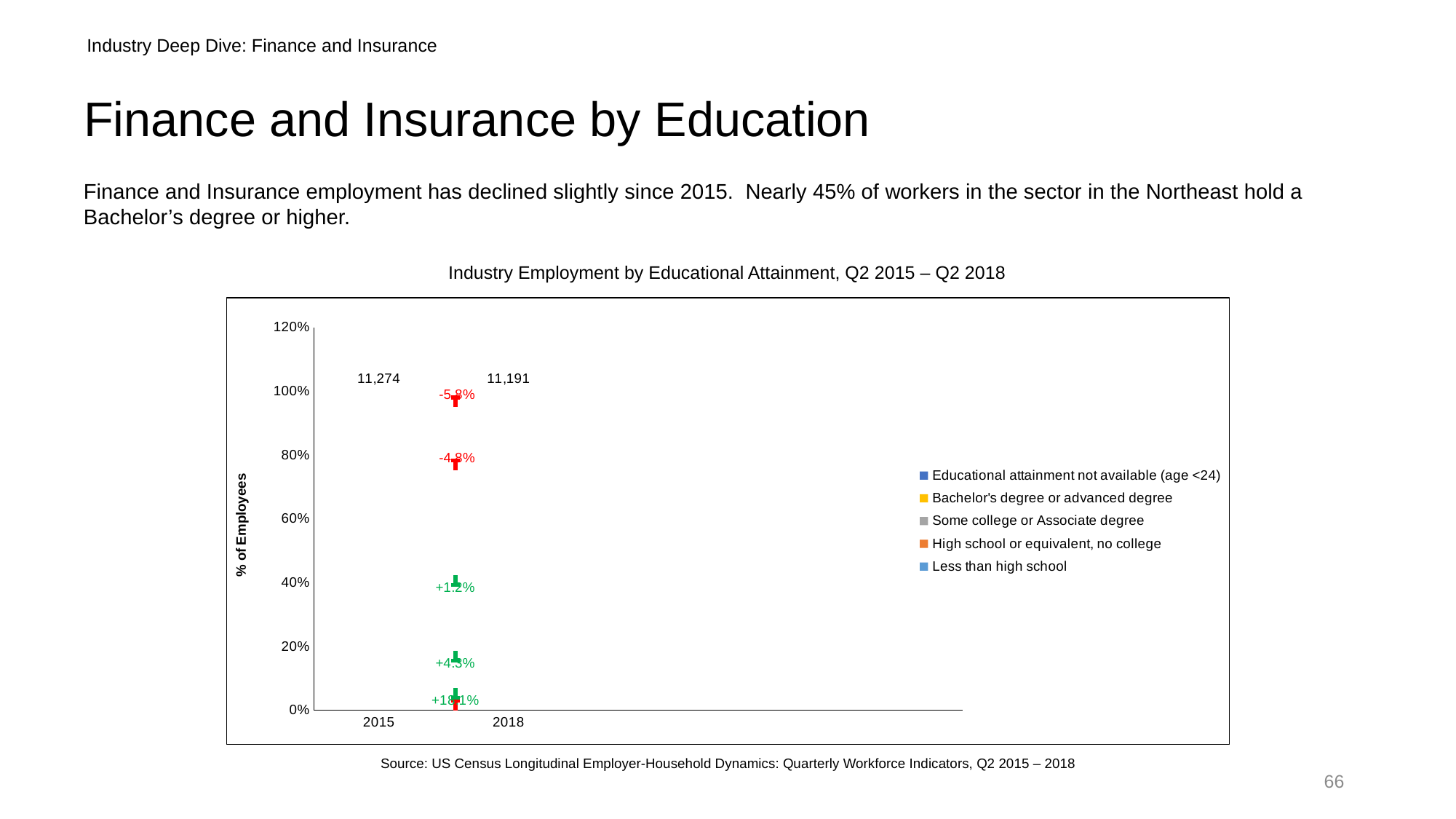
Which year has the larger total employment figure printed on the chart, 2015 or 2018? 2015 How many years are shown on the x axis of the chart? 2 How many series does the chart's legend list? 5 Does the total employment figure printed on the chart fall or rise from 2015 to 2018? fall What is the difference between the total employment figures printed for 2015 and 2018? 83 What total employment figure is printed above the 2015 column in the chart? 11,274 What total employment figure is printed above the 2018 column in the chart? 11,191 What is the highest value shown on the y axis of the chart? 120% What is the title of the chart? Industry Employment by Educational Attainment, Q2 2015 – Q2 2018 What is the label on the y axis of the chart? % of Employees